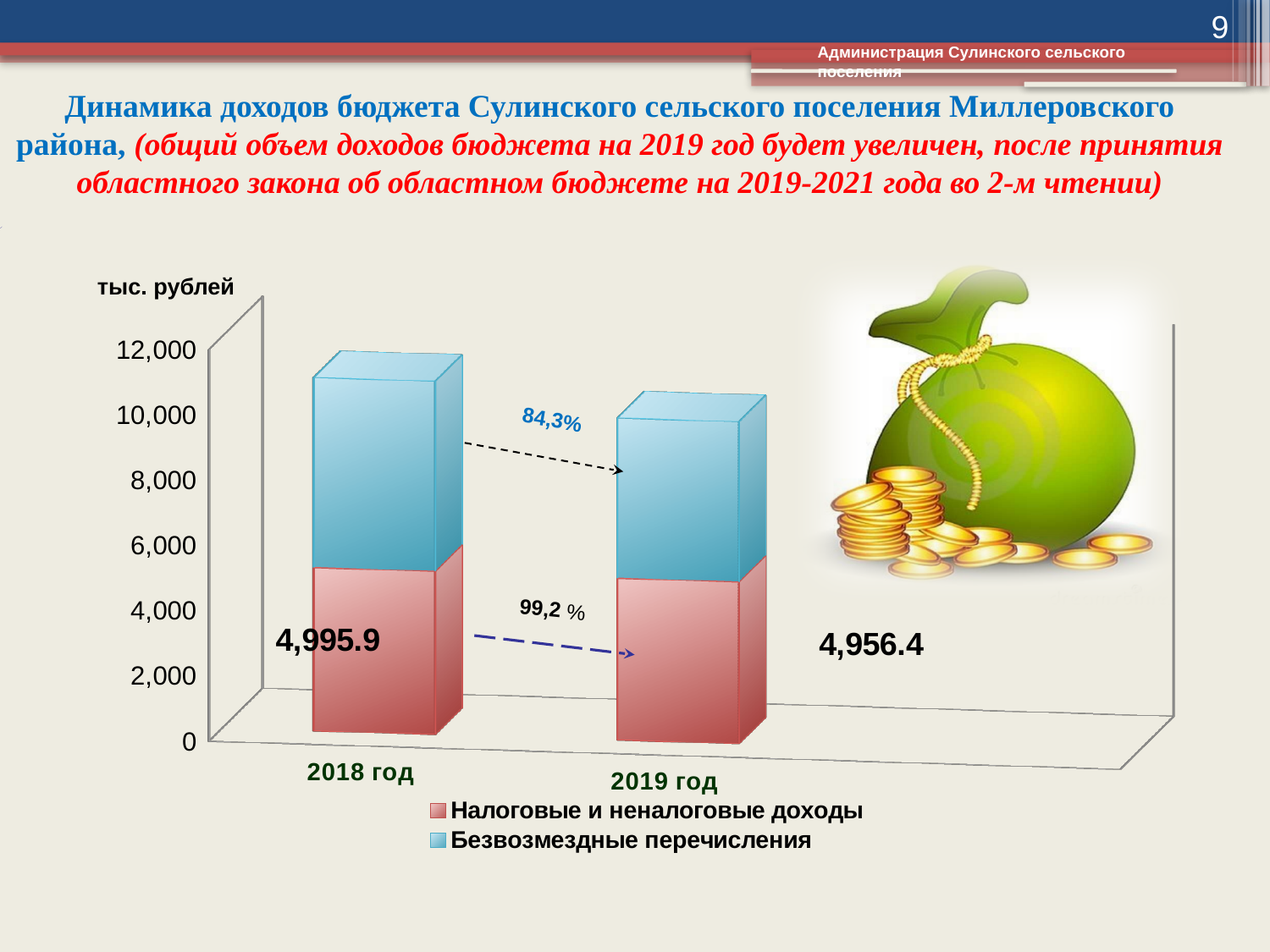
Which year has the larger value of Налоговые и неналоговые доходы, 2018 год or 2019 год? 2018 год Which series is shown in blue in the legend? Безвозмездные перечисления What is the value of Налоговые и неналоговые доходы for 2019 год? 4,956.4 What unit of measurement is shown above the vertical axis? тыс. рублей How many series does the chart legend list? 2 What type of chart is shown on the slide? stacked bar chart What is the difference between Налоговые и неналоговые доходы in 2018 год and 2019 год? 39.5 Is the total stacked bar for 2018 год greater or less than 10,000? greater Is the total stacked bar for 2019 год greater or less than 8,000? greater Which year has the taller total stacked bar? 2018 год What is the value of Налоговые и неналоговые доходы for 2018 год? 4,995.9 How many years (categories) are plotted on the chart? 2